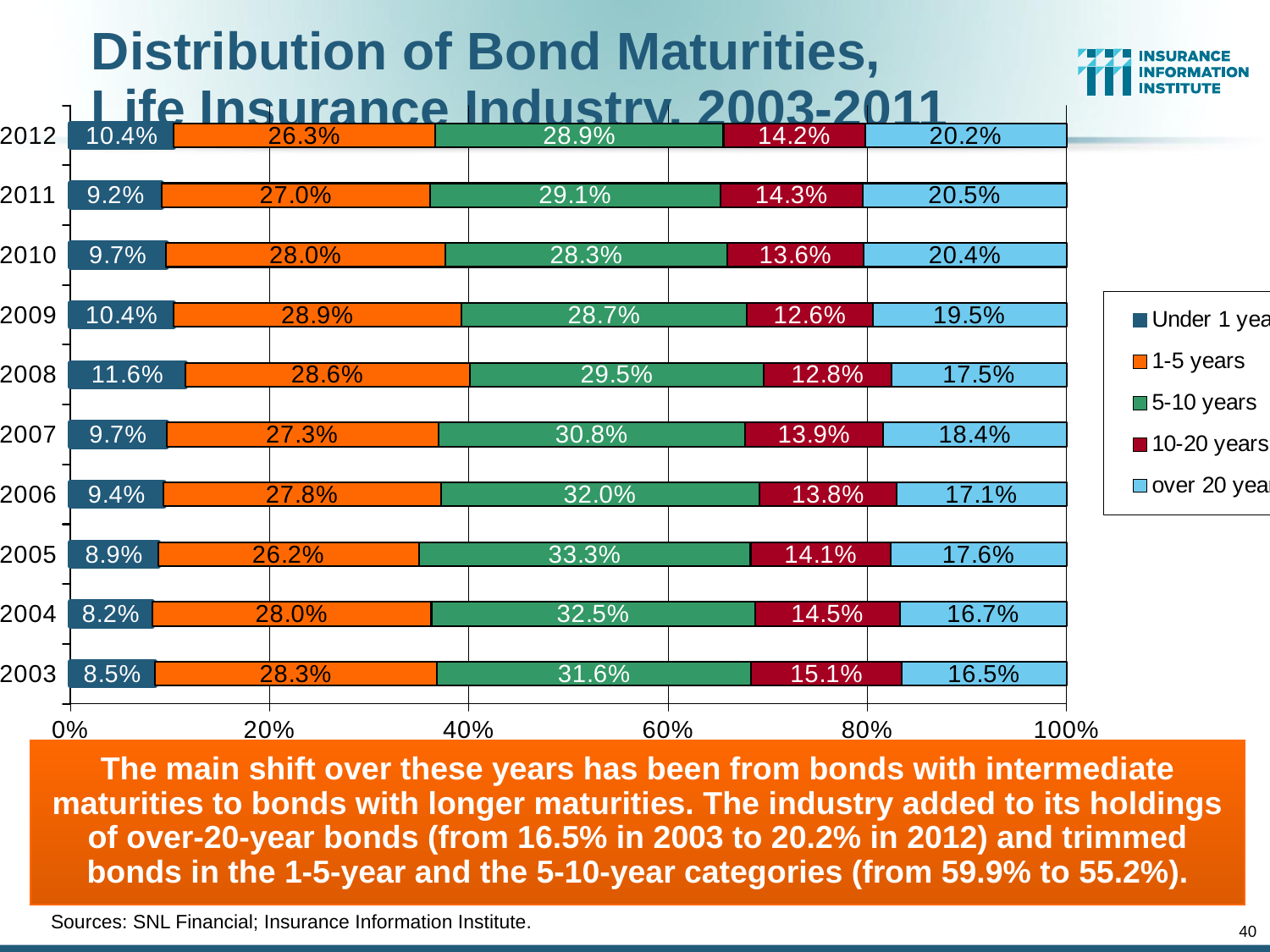
In which year was the share of bonds with maturities over 20 years lowest? 2003 What type of chart is shown on the slide? Stacked bar chart What is the share of 10-20 year bonds in 2003? 15.1% What is the share of 5-10 year bonds in 2005? 33.3% How many years are shown on the chart? 10 What colour represents the 1-5 years category in the chart? Orange In which year was the share of 5-10 year bonds highest? 2005 How many maturity categories does the legend list? 5 Which year had a larger share of 5-10 year bonds, 2006 or 2007? 2006 What is the share of bonds with maturities under 1 year in 2008? 11.6% By how many percentage points did the share of over-20-year bonds change from 2003 to 2012? 3.7 percentage points What is the share of bonds with maturities over 20 years in 2012? 20.2%